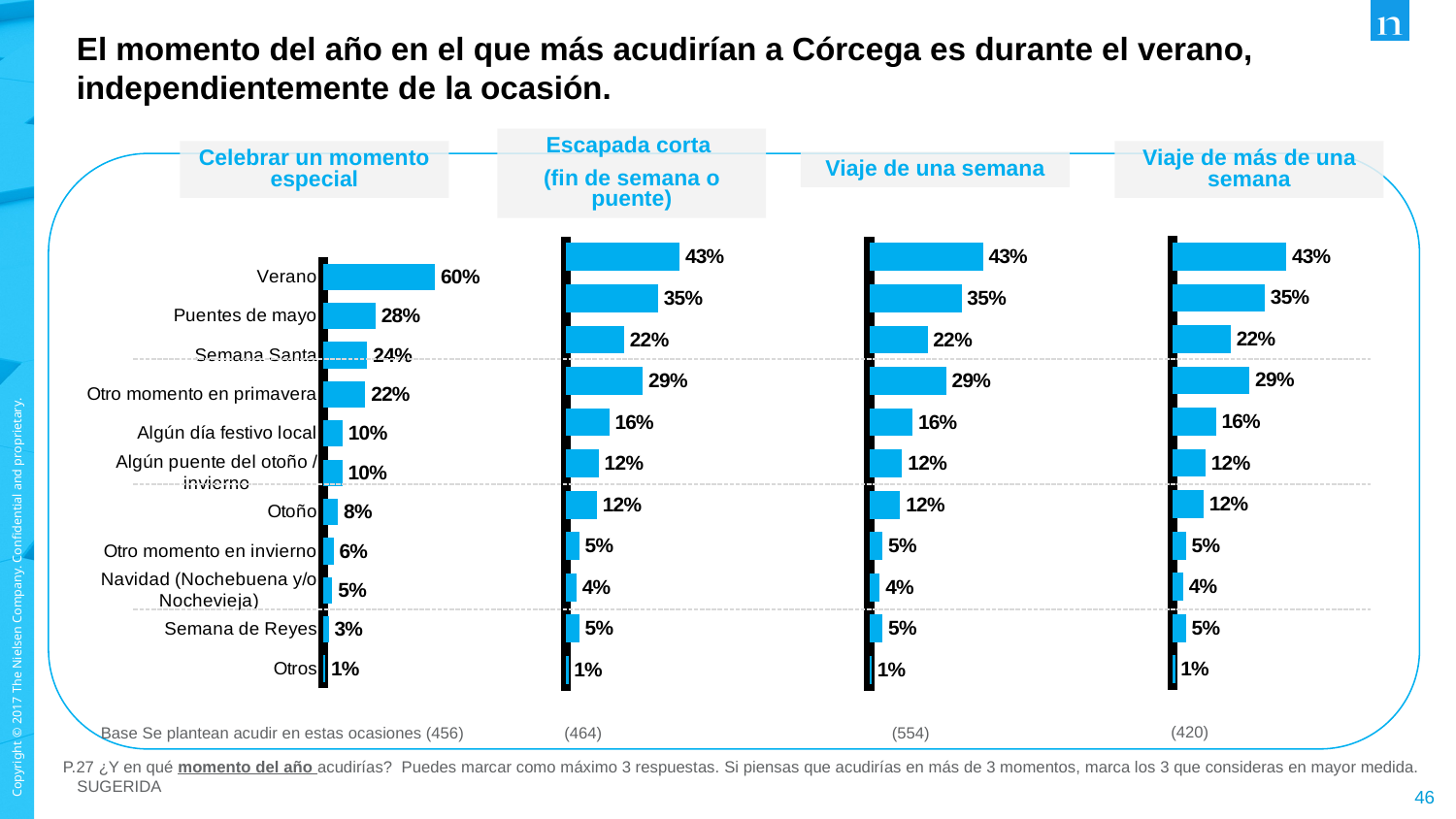
In the 'Viaje de más de una semana' chart, what is the value for Algún día festivo local? 16% What kind of chart is used for 'Viaje de una semana'? Bar chart In the 'Celebrar un momento especial' chart, which is larger: Semana Santa or Otro momento en primavera? Semana Santa In the 'Viaje de una semana' chart, what is the value for Otro momento en primavera? 29% In the 'Celebrar un momento especial' chart, what is the difference between the values for Verano and Puentes de mayo? 32 percentage points In the 'Celebrar un momento especial' chart, which category has the lowest value? Otros What is the base (number of respondents) shown under the 'Viaje de una semana' chart? 554 In the 'Celebrar un momento especial' chart, what is the value for Puentes de mayo? 28% How many categories are shown in the 'Celebrar un momento especial' chart? 11 In the 'Celebrar un momento especial' chart, what is the value for Verano? 60% In the 'Escapada corta (fin de semana o puente)' chart, which category has the highest value? Verano In the 'Escapada corta (fin de semana o puente)' chart, which is larger: Semana Santa or Otro momento en primavera? Otro momento en primavera